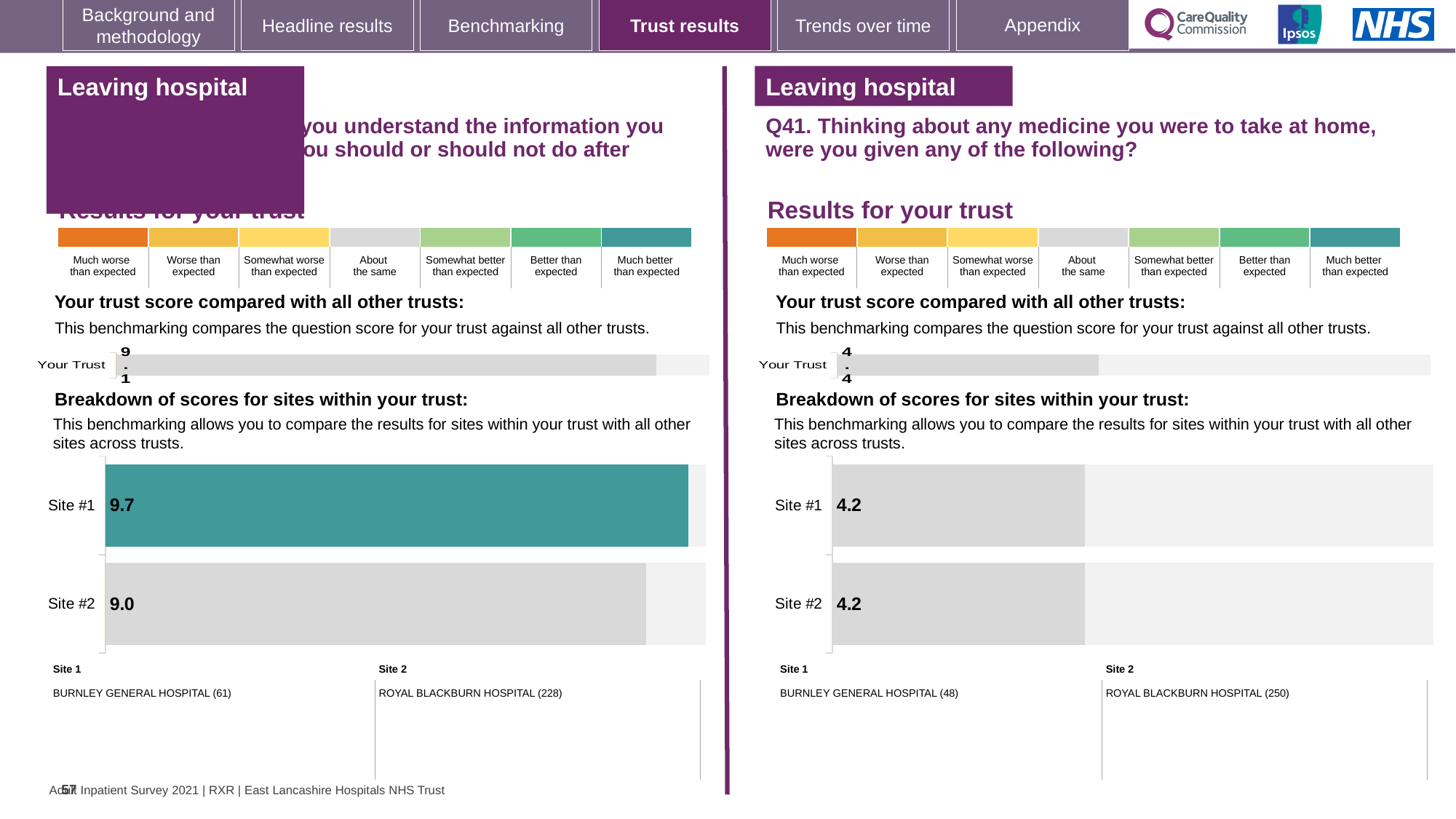
On the left-hand chart, what is the score for Site #1? 9.7 On the left-hand chart, which site has the higher score? Site #1 On the Q41 chart on the right, what is the 'Your Trust' score? 4.4 On the left-hand chart, what is the score for Site #2? 9.0 On the Q41 chart on the right, how many sites are shown in the breakdown? 2 On the left-hand chart, is the Site #1 bar coloured differently from the Site #2 bar? Yes On the Q41 chart on the right, what is the score for Site #2? 4.2 On the left-hand chart, what is the difference between the Site #1 and Site #2 scores? 0.7 On the Q41 chart on the right, what is the score for Site #1? 4.2 What kind of chart is used to show the breakdown of scores for sites on the left-hand side? Bar chart On the Q41 chart on the right, is the Site #1 score larger than, smaller than, or equal to the Site #2 score? Equal On the left-hand chart, what is the 'Your Trust' score? 9.1